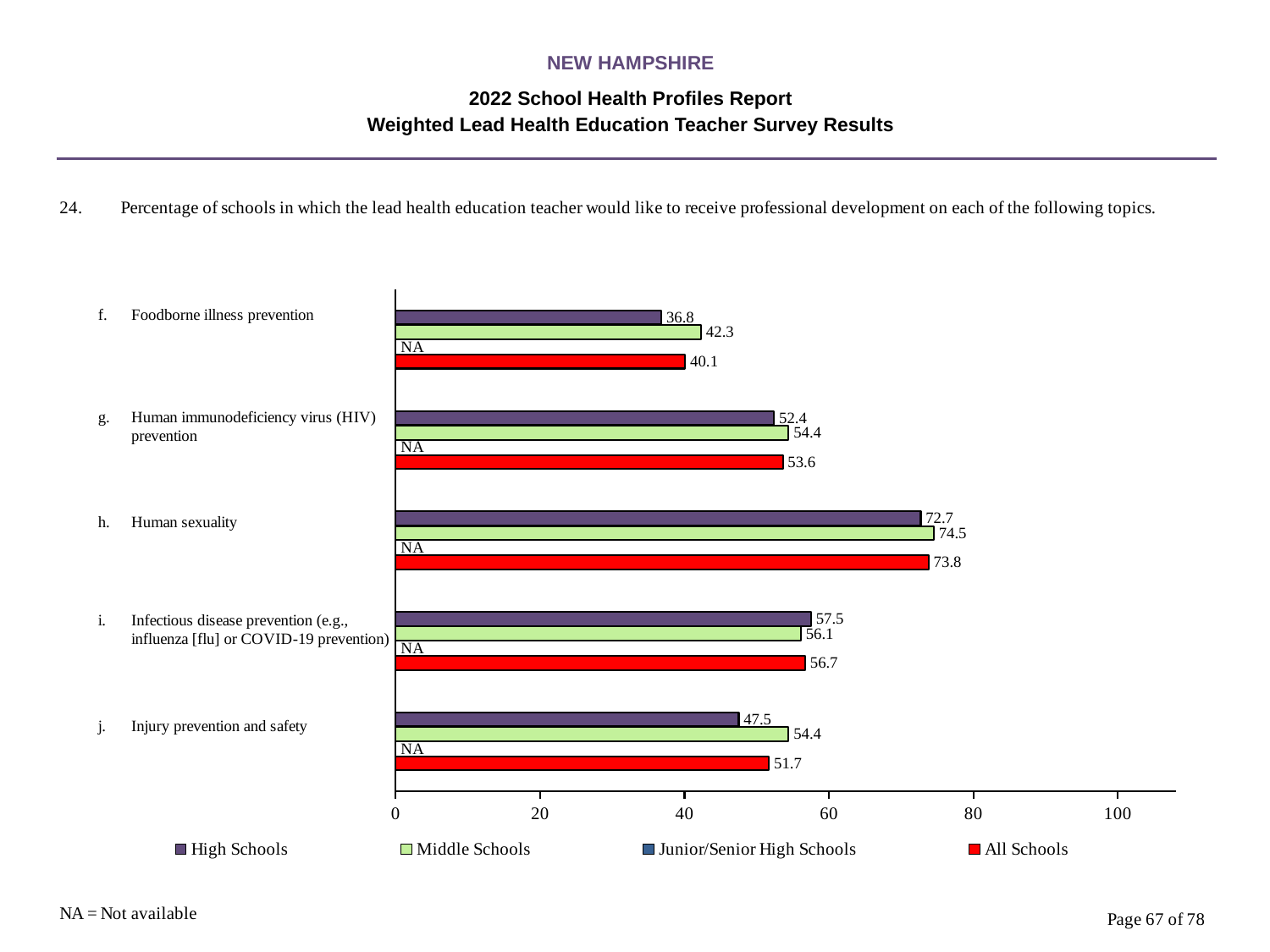
Which is larger for Infectious disease prevention: the High Schools value or the Middle Schools value? High Schools What is the difference between the Middle Schools and High Schools values for Injury prevention and safety? 6.9 What kind of chart is shown on the slide? bar chart What is the value for Junior/Senior High Schools for Human immunodeficiency virus (HIV) prevention? NA Which topic has the lowest value for High Schools? Foodborne illness prevention What is the value for Middle Schools for Foodborne illness prevention? 42.3 Which topic has the highest value for All Schools? Human sexuality Is the All Schools value for Foodborne illness prevention greater or less than 60? less What is the value for All Schools for Injury prevention and safety? 51.7 How many series does the legend list? 4 How many topics are shown on the chart? 5 What is the value for High Schools for Human sexuality? 72.7